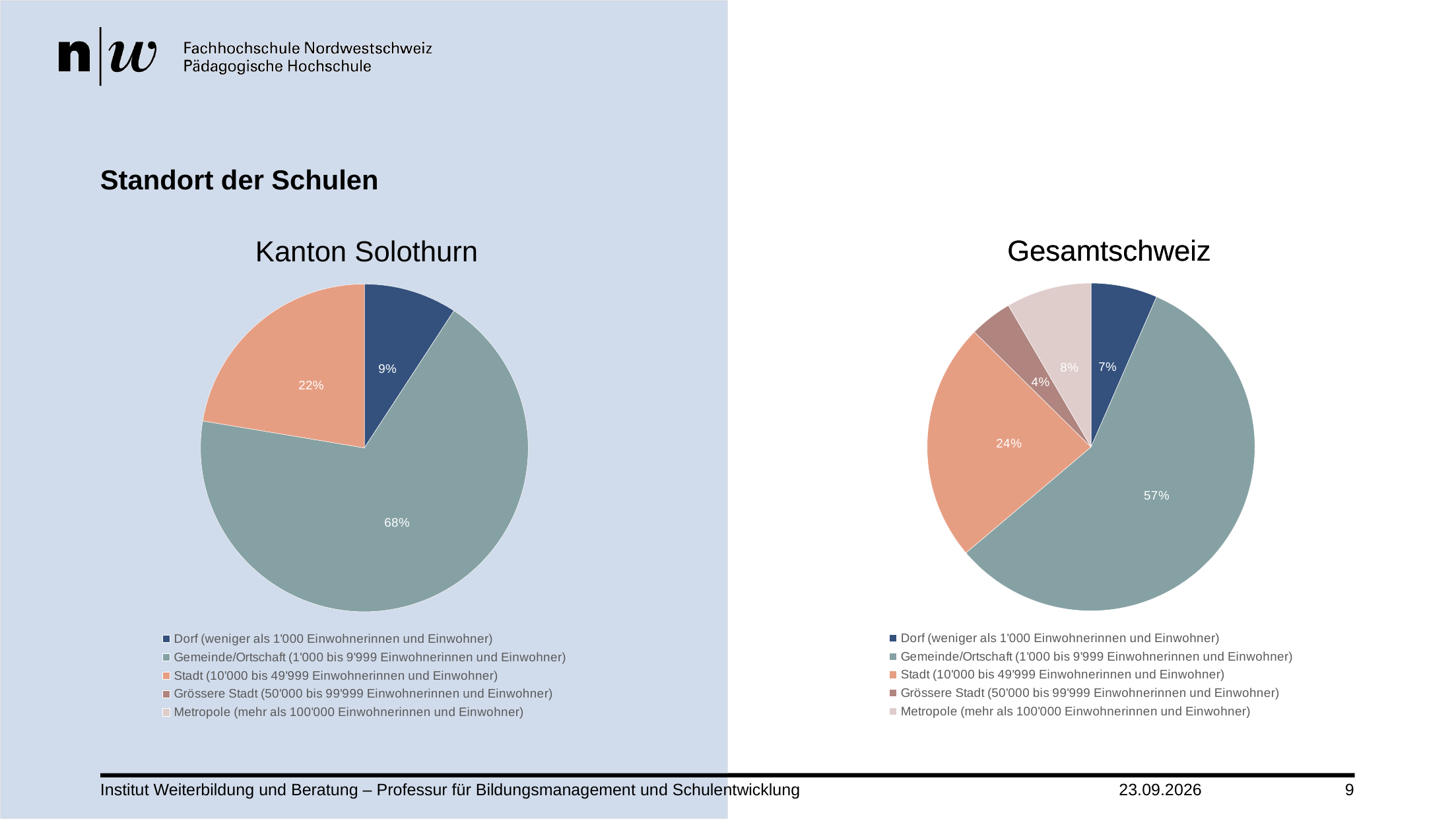
In the Kanton Solothurn chart, which category has the smallest labelled slice? Dorf (weniger als 1'000 Einwohnerinnen und Einwohner) In the Gesamtschweiz chart, which category has the largest slice? Gemeinde/Ortschaft (1'000 bis 9'999 Einwohnerinnen und Einwohner) In the Gesamtschweiz chart, what share is shown for Dorf (weniger als 1'000 Einwohnerinnen und Einwohner)? 7% In the Kanton Solothurn chart, what share of schools is in the Gemeinde/Ortschaft category? 68% How many categories does the legend of the Gesamtschweiz chart list? 5 What type of chart is used for Kanton Solothurn and Gesamtschweiz? Pie chart In the Gesamtschweiz chart, which category has the smallest slice? Grössere Stadt (50'000 bis 99'999 Einwohnerinnen und Einwohner) In the Kanton Solothurn chart, what share is labelled for Stadt (10'000 bis 49'999 Einwohnerinnen und Einwohner)? 22% Is the Stadt share larger in the Kanton Solothurn chart or in the Gesamtschweiz chart? Gesamtschweiz What is the difference between the Gemeinde/Ortschaft share in the Kanton Solothurn chart and in the Gesamtschweiz chart? 11 percentage points In the Gesamtschweiz chart, what share is shown for Metropole (mehr als 100'000 Einwohnerinnen und Einwohner)? 8% In the Gesamtschweiz chart, what is the difference between the Stadt share and the Dorf share? 17 percentage points